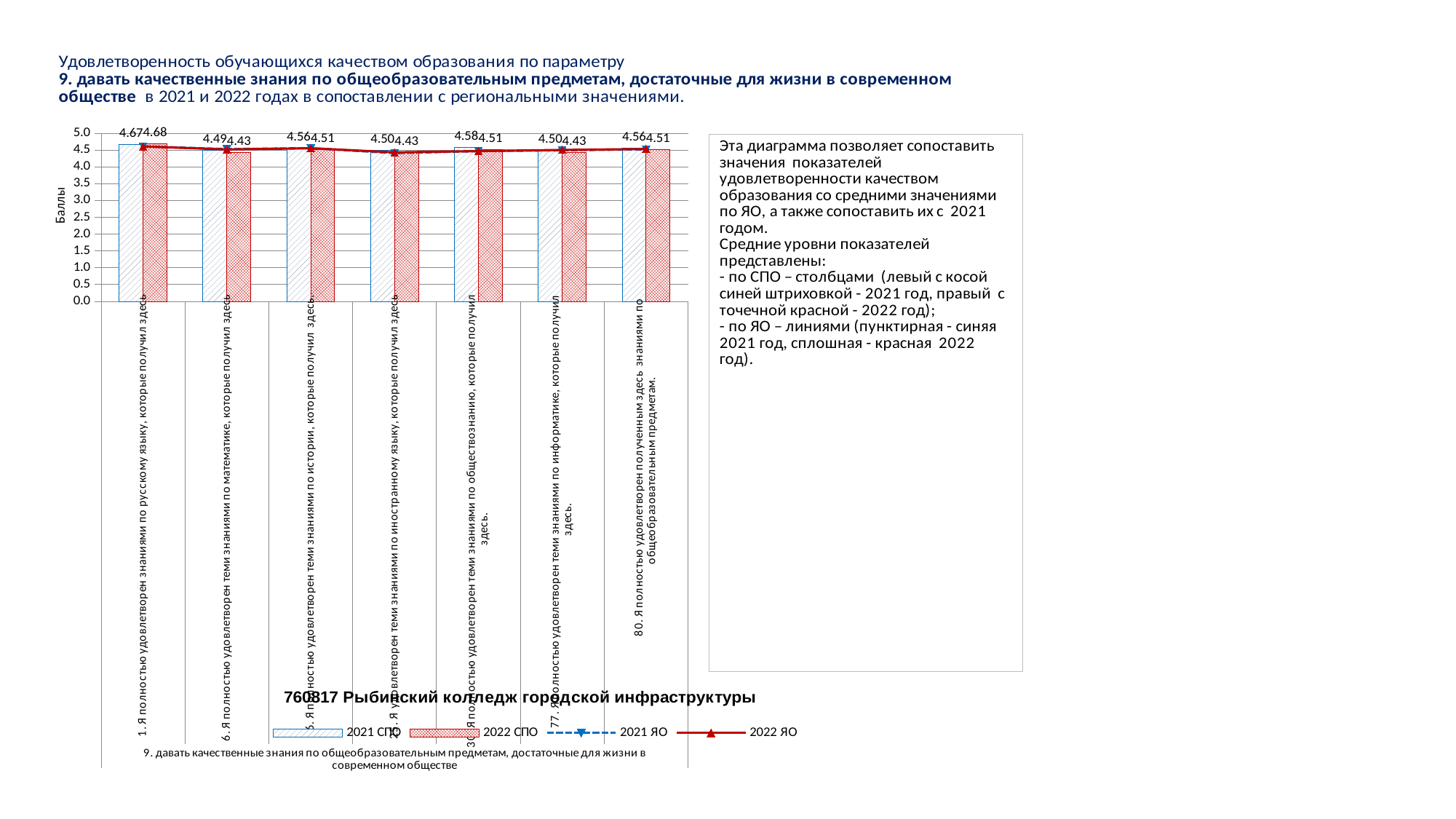
How many categories are plotted along the x axis of the chart? 7 What two values are labelled above the second category (6. ... по математике ...)? 4.49 and 4.43 What is the highest data label value shown on the chart? 4.68 Is the 2021 СПО bar for the first category (по русскому языку) greater or less than 4.0? greater What is the lowest data label value shown on the chart? 4.43 Is the 2022 СПО bar for the last category (80. Я полностью удовлетворен полученным здесь знаниями...) greater or less than 3.0? greater How many series does the chart legend list? 4 What kind of chart is shown on the slide? A combined bar and line chart What is the title of the vertical axis of the chart? Баллы What two values are labelled above the first category (1. Я полностью удовлетворен знаниями по русскому языку...)? 4.67 and 4.68 What are the four legend entries of the chart? 2021 СПО, 2022 СПО, 2021 ЯО, 2022 ЯО What is the difference between the two labelled values for the second category (4.49 and 4.43)? 0.06